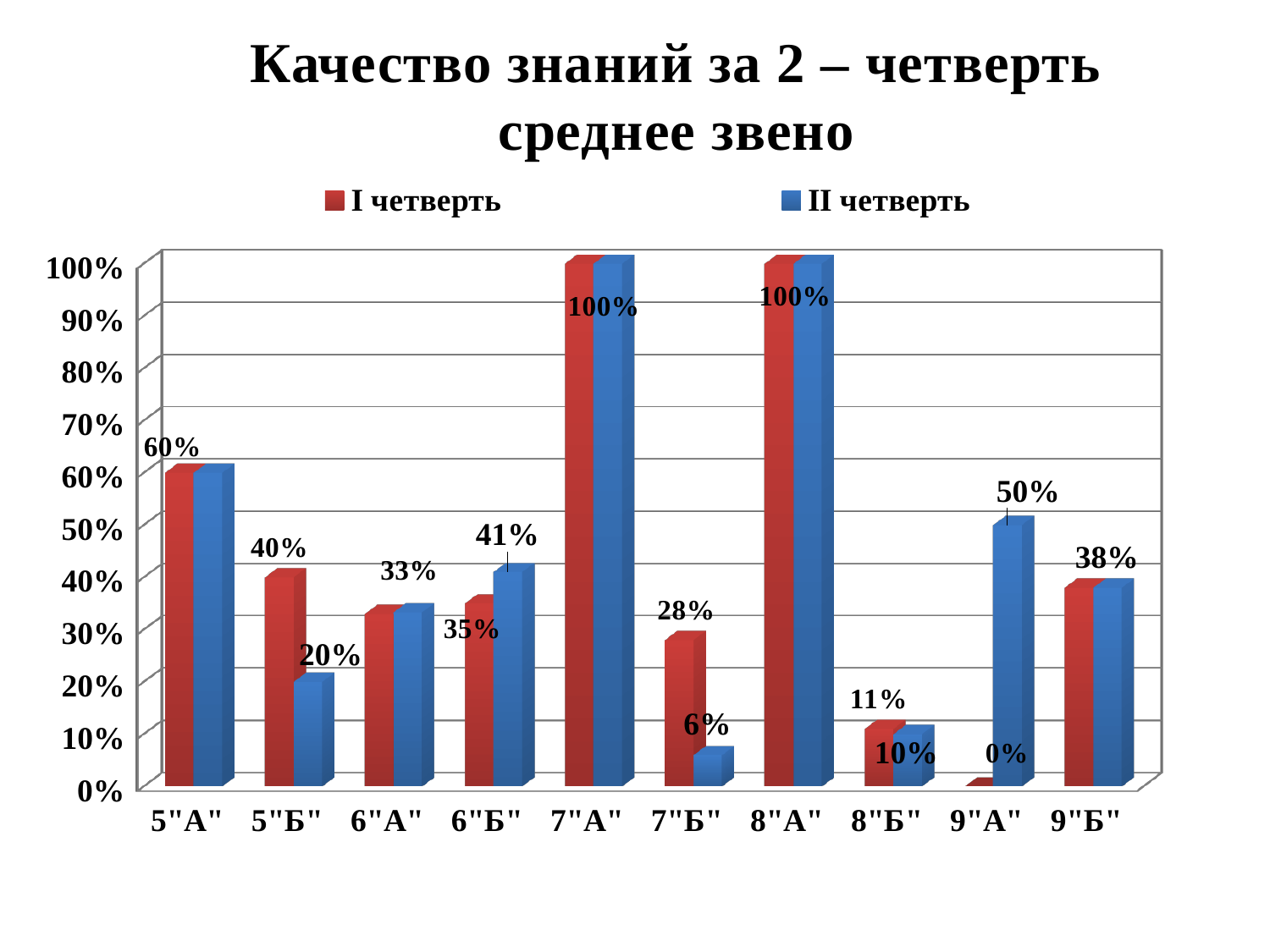
Which class has the lowest value in II четверть? 7"Б" Which class has the lowest value in I четверть? 9"А" How many series does the legend list? 2 What type of chart is shown on the slide? bar chart Is the value for 9"Б" in II четверть greater or less than 30%? greater What is the value for 5"Б" in II четверть? 20% What is the value for 9"А" in II четверть? 50% What is the difference between the I четверть and II четверть values for 5"Б"? 20% What is the value for 6"Б" in II четверть? 41% What is the value for 7"Б" in I четверть? 28% For 6"Б", which series has the larger value, I четверть or II четверть? II четверть How many classes (categories) are shown on the x axis? 10